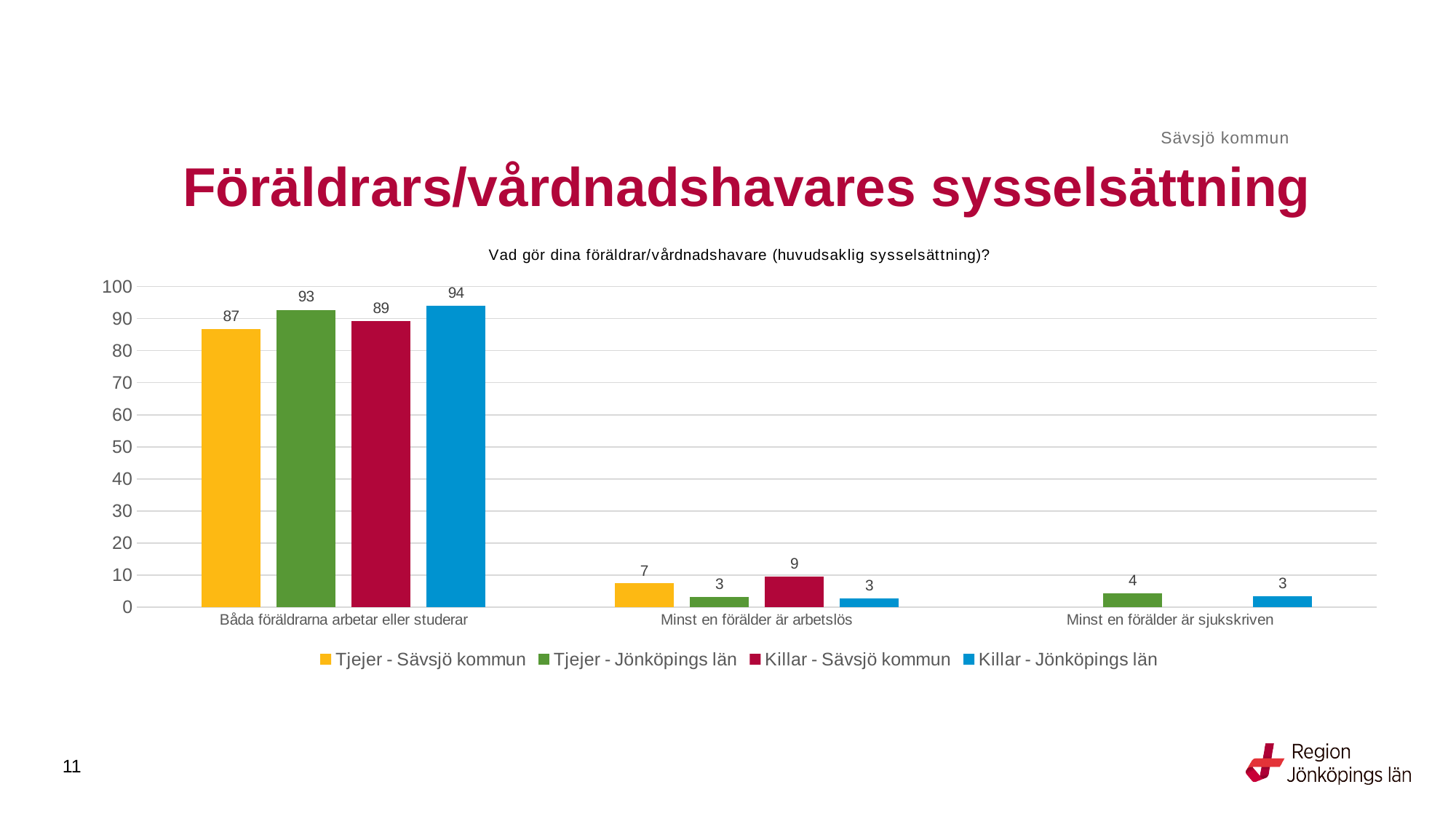
What is the value for Tjejer - Sävsjö kommun in the category 'Båda föräldrarna arbetar eller studerar'? 87 Is the value for Killar - Sävsjö kommun in 'Båda föräldrarna arbetar eller studerar' greater or less than 80? greater In the category 'Minst en förälder är arbetslös', which is larger: Tjejer - Sävsjö kommun or Killar - Sävsjö kommun? Killar - Sävsjö kommun What is the value for Killar - Jönköpings län in the category 'Minst en förälder är arbetslös'? 3 What is the difference between Killar - Jönköpings län and Tjejer - Sävsjö kommun in the category 'Båda föräldrarna arbetar eller studerar'? 7 What kind of chart is shown on the slide? Bar chart How many categories are shown on the x axis? 3 Which series has the highest value in the category 'Båda föräldrarna arbetar eller studerar'? Killar - Jönköpings län How many series does the legend list? 4 What is the value for Tjejer - Jönköpings län in the category 'Minst en förälder är sjukskriven'? 4 Which series has the lowest value in the category 'Båda föräldrarna arbetar eller studerar'? Tjejer - Sävsjö kommun What colour represents Killar - Sävsjö kommun in the chart? Red